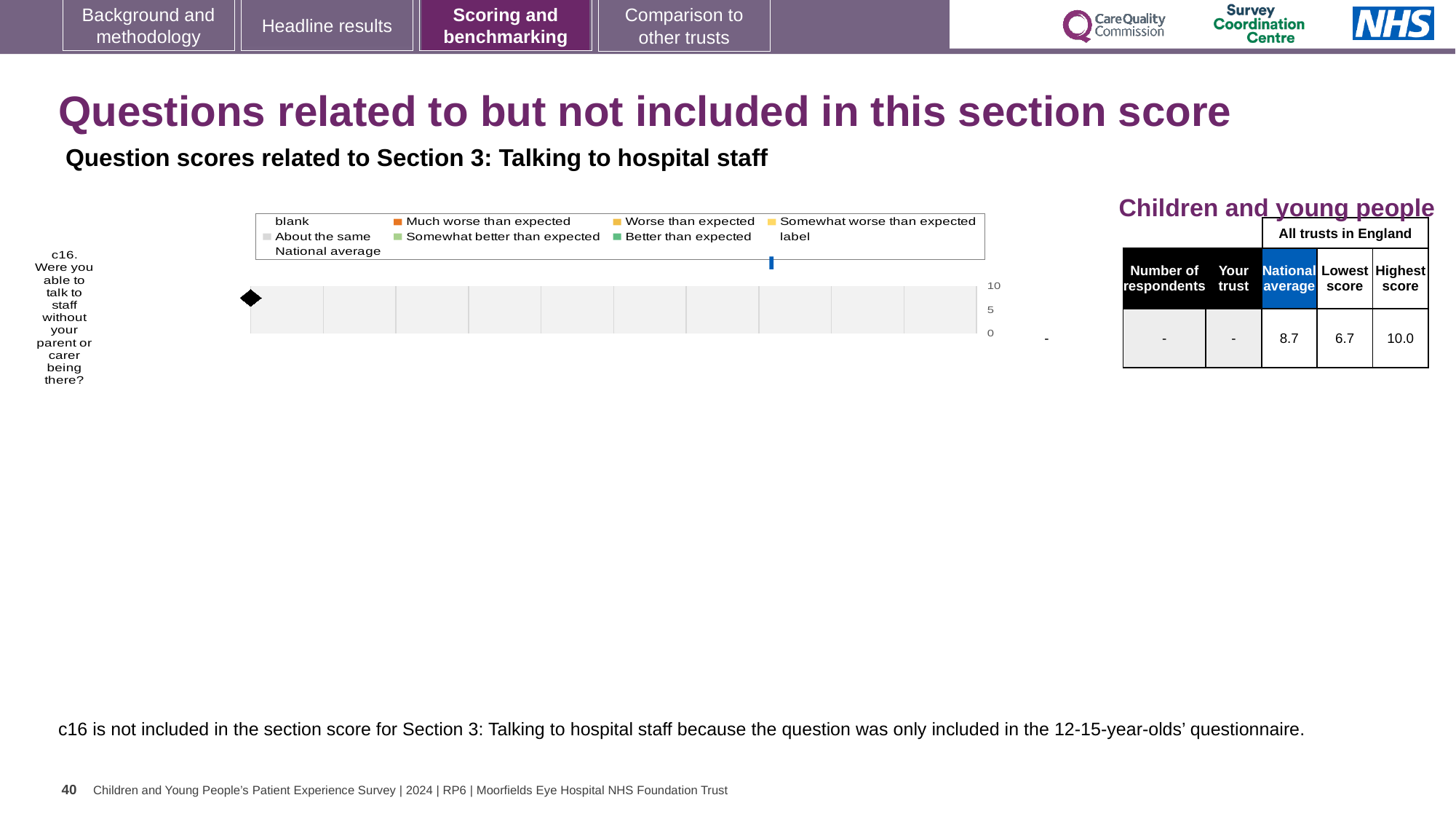
In the table next to the chart, what is the Lowest score for c16? 6.7 In the table next to the chart, what is the Highest score for c16? 10.0 In the table next to the chart, what is the difference between the Highest score and the Lowest score for c16? 3.3 Which question number is the category on the chart? c16 What kind of chart is shown on the slide? bar chart In the table next to the chart, what is the National average score for c16? 8.7 How many question categories are plotted on the chart? 1 What is the highest value shown on the chart's axis? 10 In the table next to the chart, is the National average for c16 greater or less than 5? greater